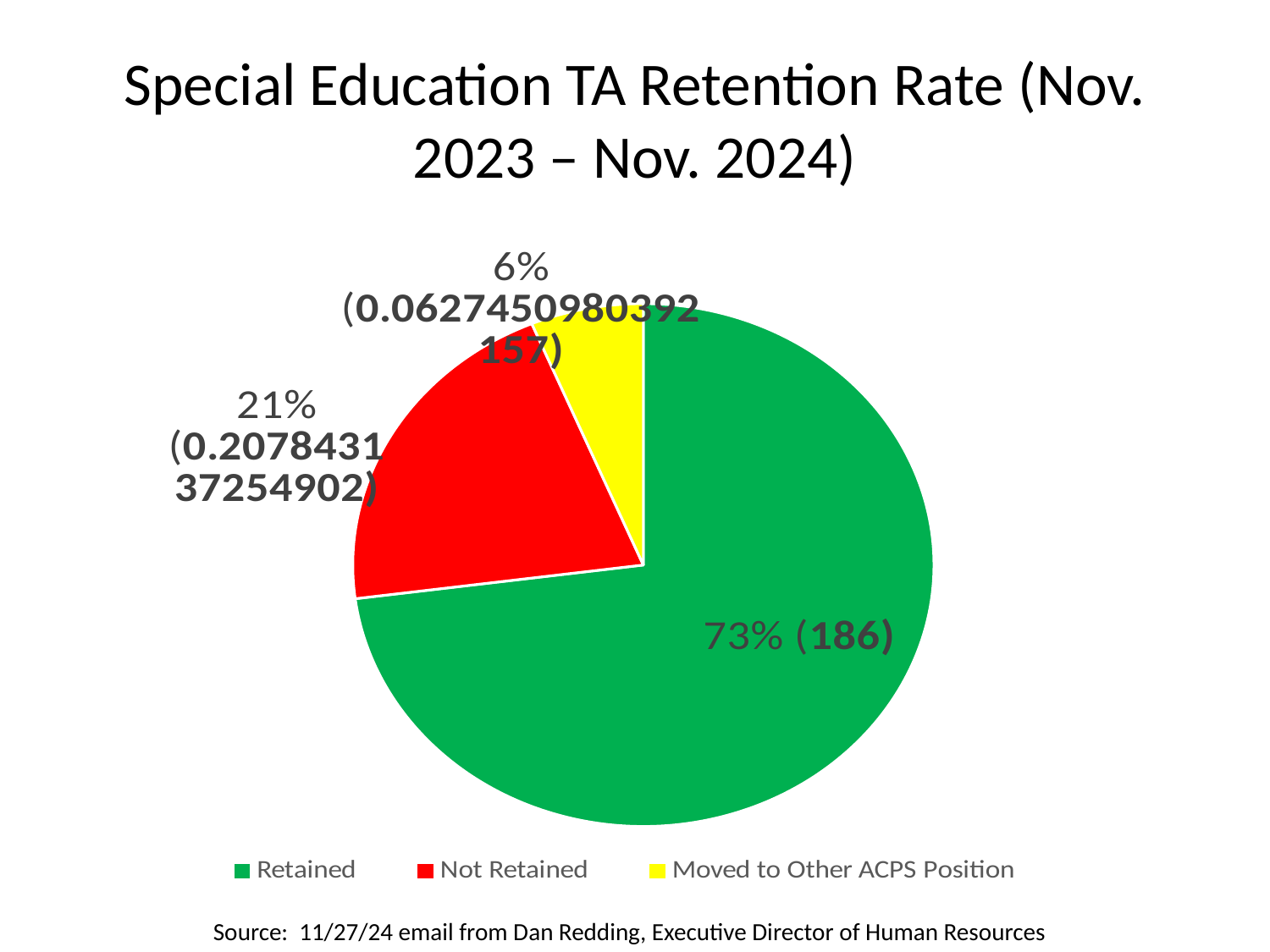
Which slice is larger, Not Retained or Moved to Other ACPS Position? Not Retained What percentage of the pie is the Not Retained slice? 21% What is the title of the chart? Special Education TA Retention Rate (Nov. 2023 – Nov. 2024) Which category has the largest slice of the pie? Retained How many categories does the legend list? 3 What is the difference in percentage points between the Retained and Not Retained slices? 52 What colour is the Not Retained slice? red What count is shown in parentheses for the Retained slice? 186 What kind of chart is shown on the slide? pie chart What percentage of the pie is the Retained slice? 73% Which category has the smallest slice of the pie? Moved to Other ACPS Position What percentage of the pie is the Moved to Other ACPS Position slice? 6%